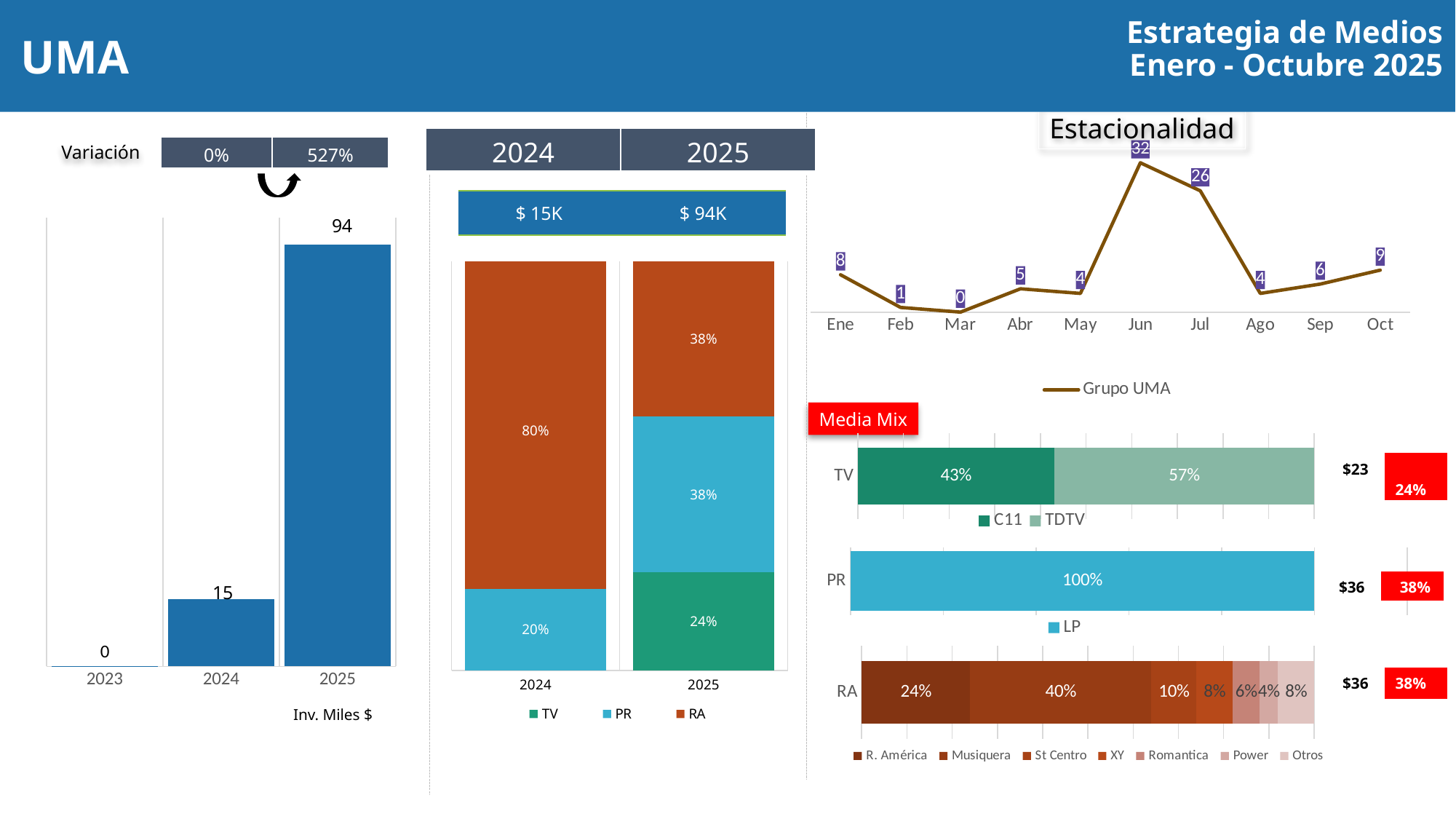
In the stacked bar chart comparing 2024 and 2025, what share does TV have in 2025? 24% In the stacked bar chart comparing 2024 and 2025, what share does RA have in 2024? 80% In the Media Mix TV bar, which is larger, C11 or TDTV? TDTV In the stacked bar chart comparing 2024 and 2025, how many series does the legend list? 3 In the Media Mix RA bar, what is the share for Musiquera? 40% In the Inv. Miles $ bar chart on the left, what is the difference between the 2025 and 2024 values? 79 In the Inv. Miles $ bar chart on the left, which year has the lowest value? 2023 In the Estacionalidad line chart, what is the value for Jul? 26 In the Estacionalidad line chart, what is the name of the series shown in the legend? Grupo UMA In the Estacionalidad line chart, how many months are plotted on the x axis? 10 In the Inv. Miles $ bar chart on the left, what is the value for 2025? 94 In the Estacionalidad line chart, which month has the highest value? Jun